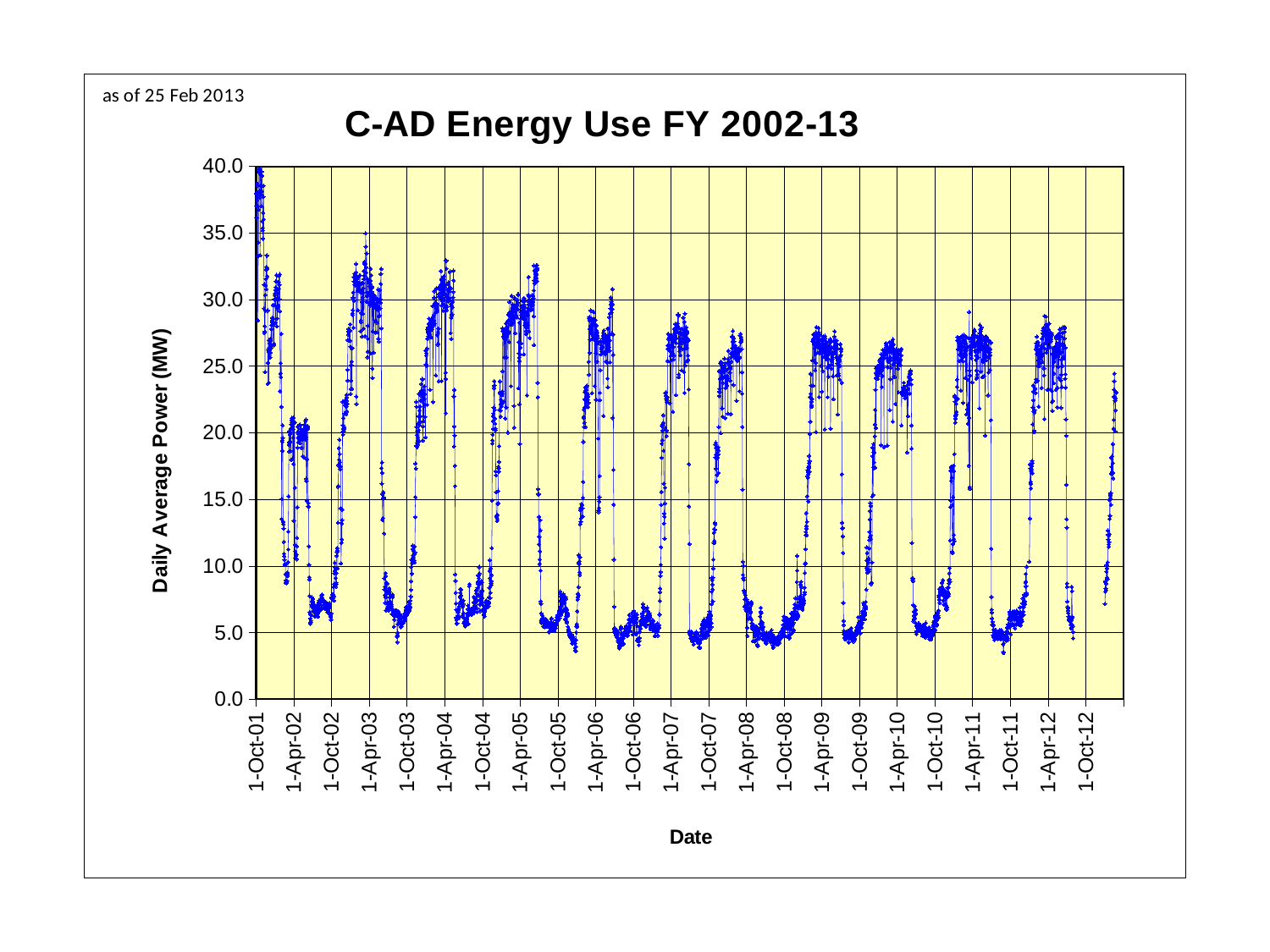
Is the highest value plotted near 1-Oct-01 greater or less than 35.0? greater What is the maximum value shown on the vertical axis? 40.0 Are the lowest values plotted around 1-Oct-08 greater or less than 10.0? less Is the peak value plotted around 1-Apr-12 greater or less than 30.0? less What is the last date label on the horizontal axis? 1-Oct-12 What is the title of the chart? C-AD Energy Use FY 2002-13 Which is larger: the peak value near 1-Oct-01 or the peak value near 1-Apr-12? 1-Oct-01 What kind of chart is shown on the slide? line chart What is the first date label on the horizontal axis? 1-Oct-01 How many date tick labels are shown on the horizontal axis? 23 What is the label on the vertical axis of the chart? Daily Average Power (MW) Do the annual peak values generally rise or fall from 2001 to 2012? fall